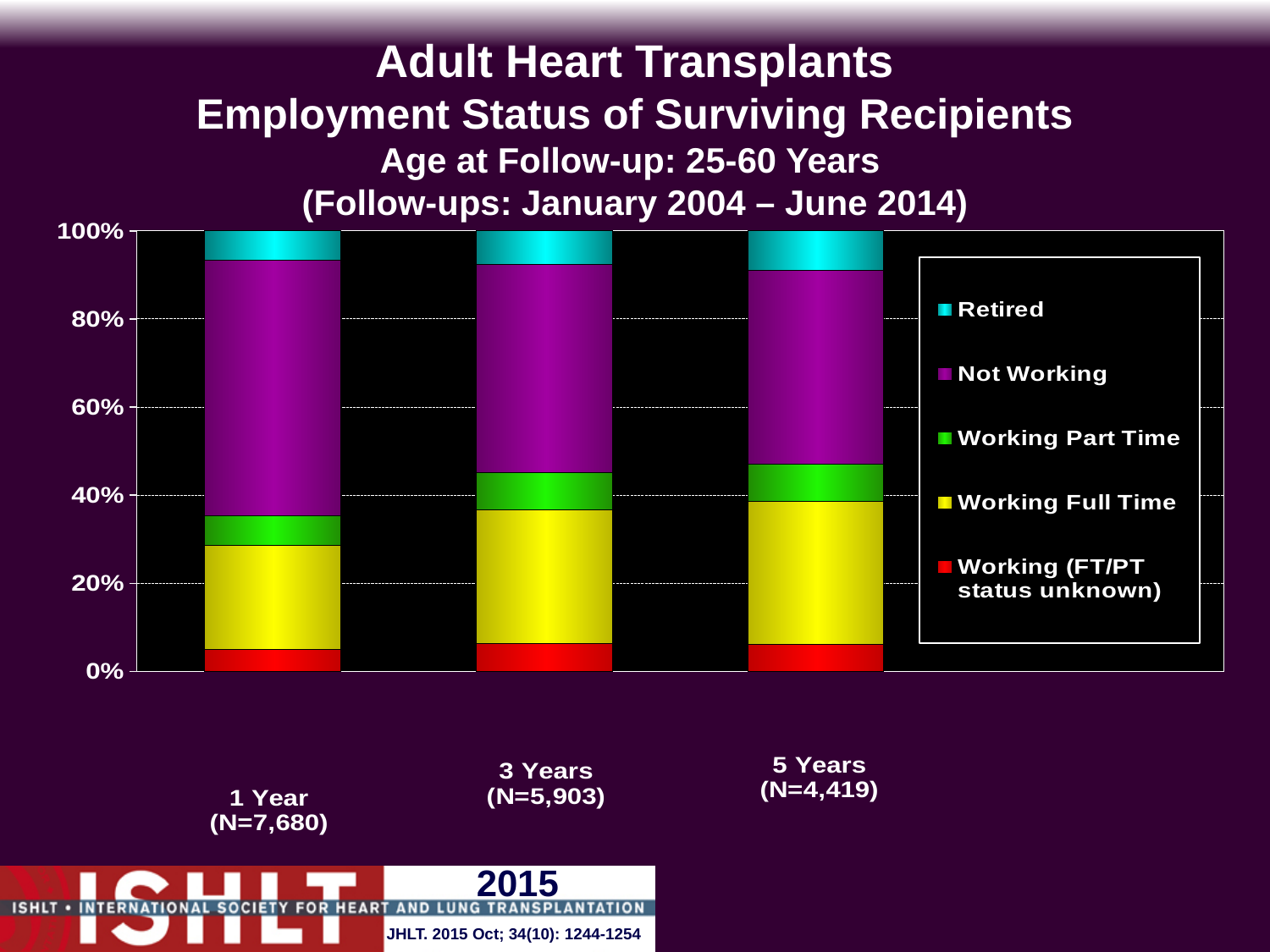
Which legend entry is shown in yellow? Working Full Time Is the Working Full Time share at 1 Year greater or less than 40%? less How many series does the legend list? 5 What kind of chart is shown on the slide? Stacked bar chart Is the Working Full Time share larger at 1 Year or at 5 Years? 5 Years Is the Not Working share at 1 Year greater or less than 40%? greater What is the sample size (N) for the 5 Years bar? N=4,419 What is the sample size (N) for the 1 Year bar? N=7,680 How many follow-up time points (bars) are shown in the chart? 3 Is the Not Working share larger at 1 Year or at 5 Years? 1 Year Does the Working Full Time share rise or fall from 1 Year to 5 Years? rise Which legend entry is shown in purple? Not Working